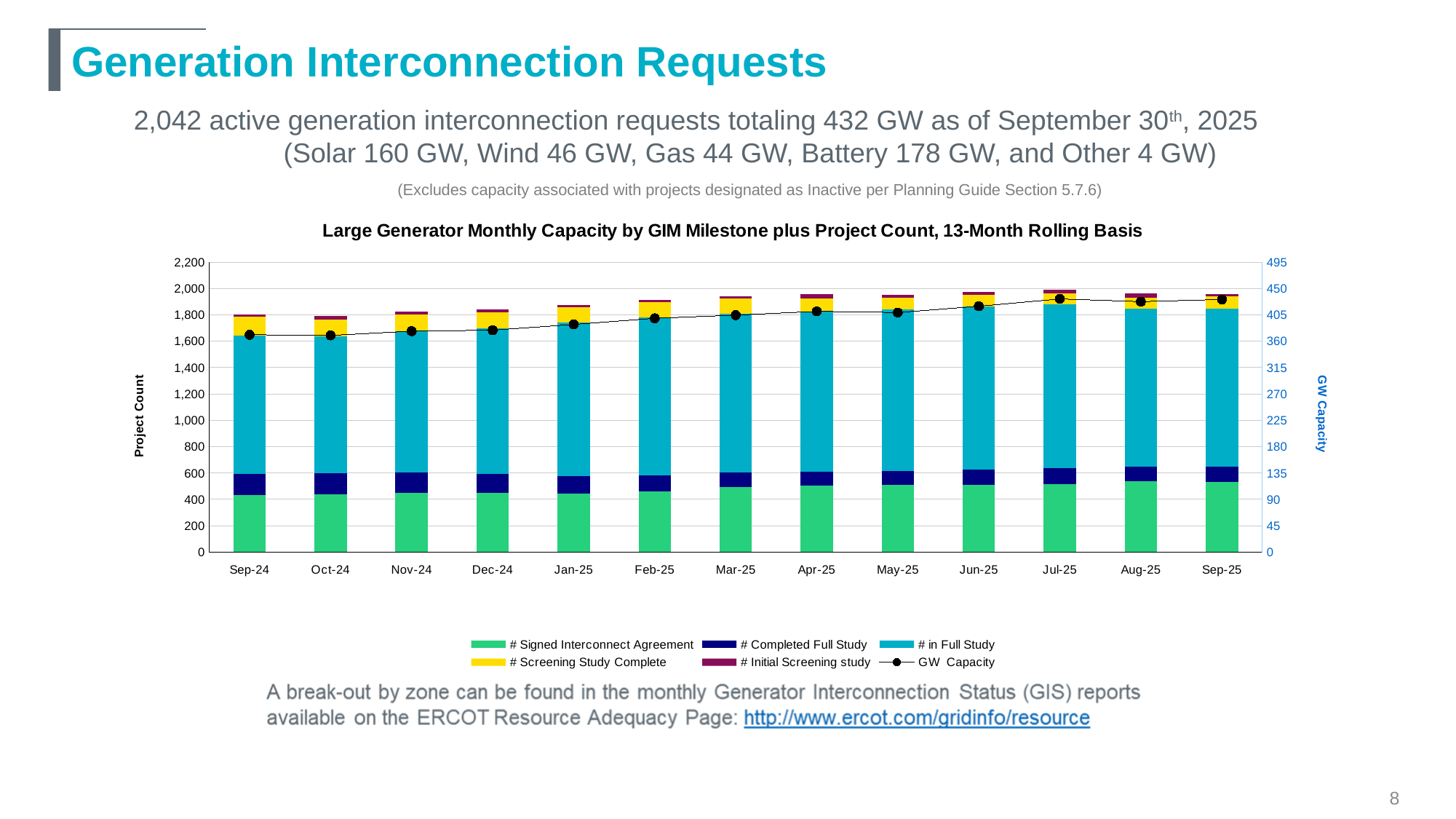
What kind of chart is shown on the slide? Stacked bar chart with a line Does the GW Capacity line generally rise or fall from Sep-24 to Sep-25? Rise Is the GW Capacity value for Sep-25 greater or less than 405 on the right axis? greater Is the total project count bar for Sep-24 greater or less than 2,000? less What is the label of the right-hand vertical axis of the chart? GW Capacity Is the GW Capacity value for Sep-24 greater or less than 405 on the right axis? less How many series does the chart legend list? 6 Which month has the larger # Signed Interconnect Agreement segment, Sep-24 or Sep-25? Sep-25 What is the title of the chart? Large Generator Monthly Capacity by GIM Milestone plus Project Count, 13-Month Rolling Basis How many months are shown along the x axis of the chart? 13